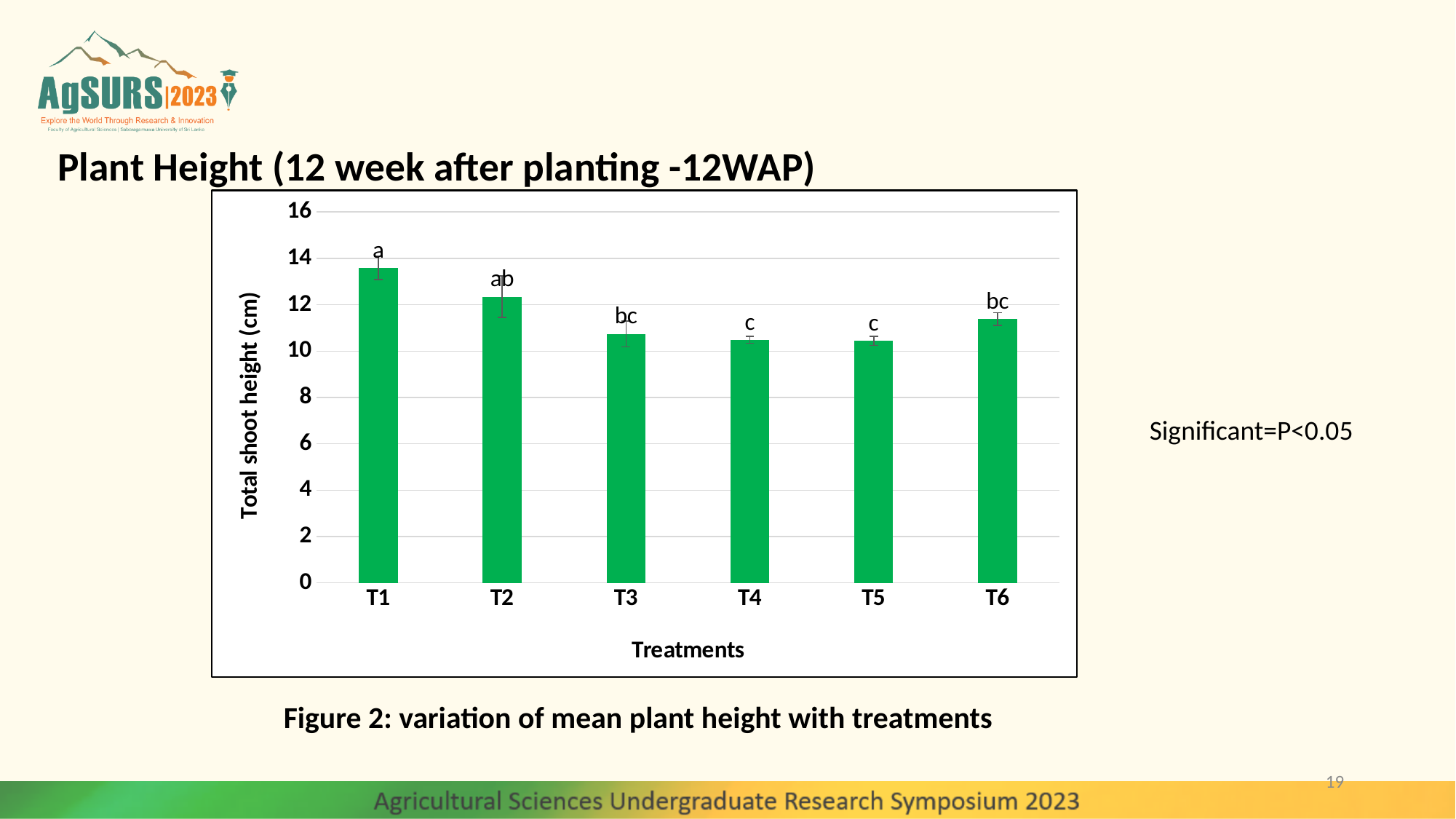
Which has the larger total shoot height, T3 or T6? T6 Is the total shoot height for T6 greater or less than 12? less How many treatments are plotted on the x axis? 6 Which treatment has the highest total shoot height? T1 What is the label on the y axis of the chart? Total shoot height (cm) Is the total shoot height for T3 greater or less than 10? greater Which has the larger total shoot height, T2 or T4? T2 Is the total shoot height for T1 greater or less than 12? greater What significance letter is printed above the T1 bar? a What kind of chart is shown on the slide? bar chart Which has the larger total shoot height, T1 or T2? T1